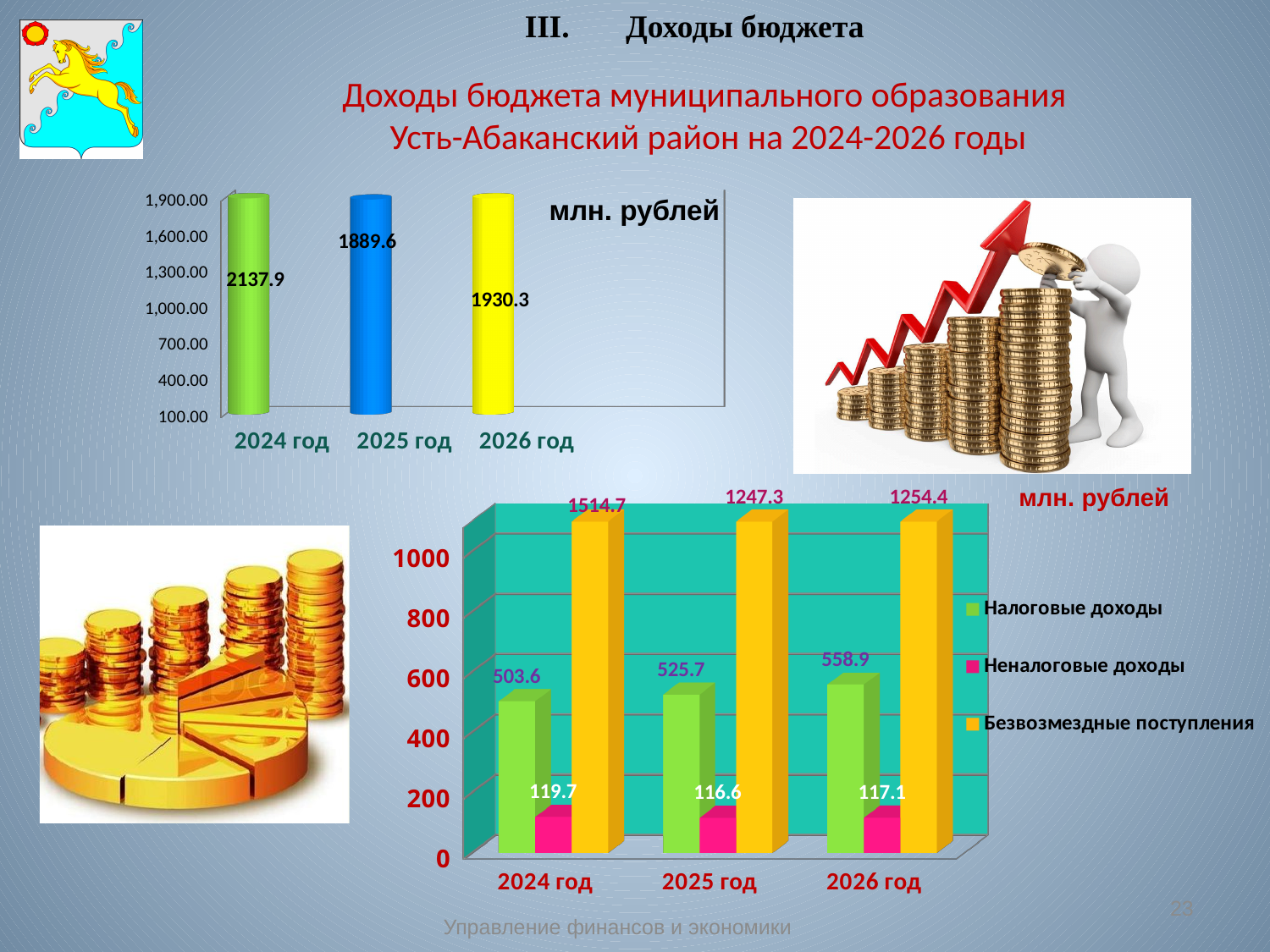
In the top-left chart, what is the difference between the values for 2024 год and 2026 год? 207.6 What type of chart is the bottom chart? bar chart In the bottom chart, what is the difference between Налоговые доходы for 2025 год and 2024 год? 22.1 In the bottom chart, which is larger: Неналоговые доходы for 2024 год or for 2025 год? 2024 год In the bottom chart, which year has the highest value of Безвозмездные поступления? 2024 год In the top-left chart, what is the value for 2024 год? 2137.9 In the top-left chart, which year has the lowest value? 2025 год In the bottom chart, what is the value of Налоговые доходы for 2026 год? 558.9 In the bottom chart, do the values of Налоговые доходы rise or fall from 2024 год to 2026 год? rise In the bottom chart, what is the value of Безвозмездные поступления for 2025 год? 1247.3 How many series does the legend of the bottom chart list? 3 How many categories does the top-left chart show? 3